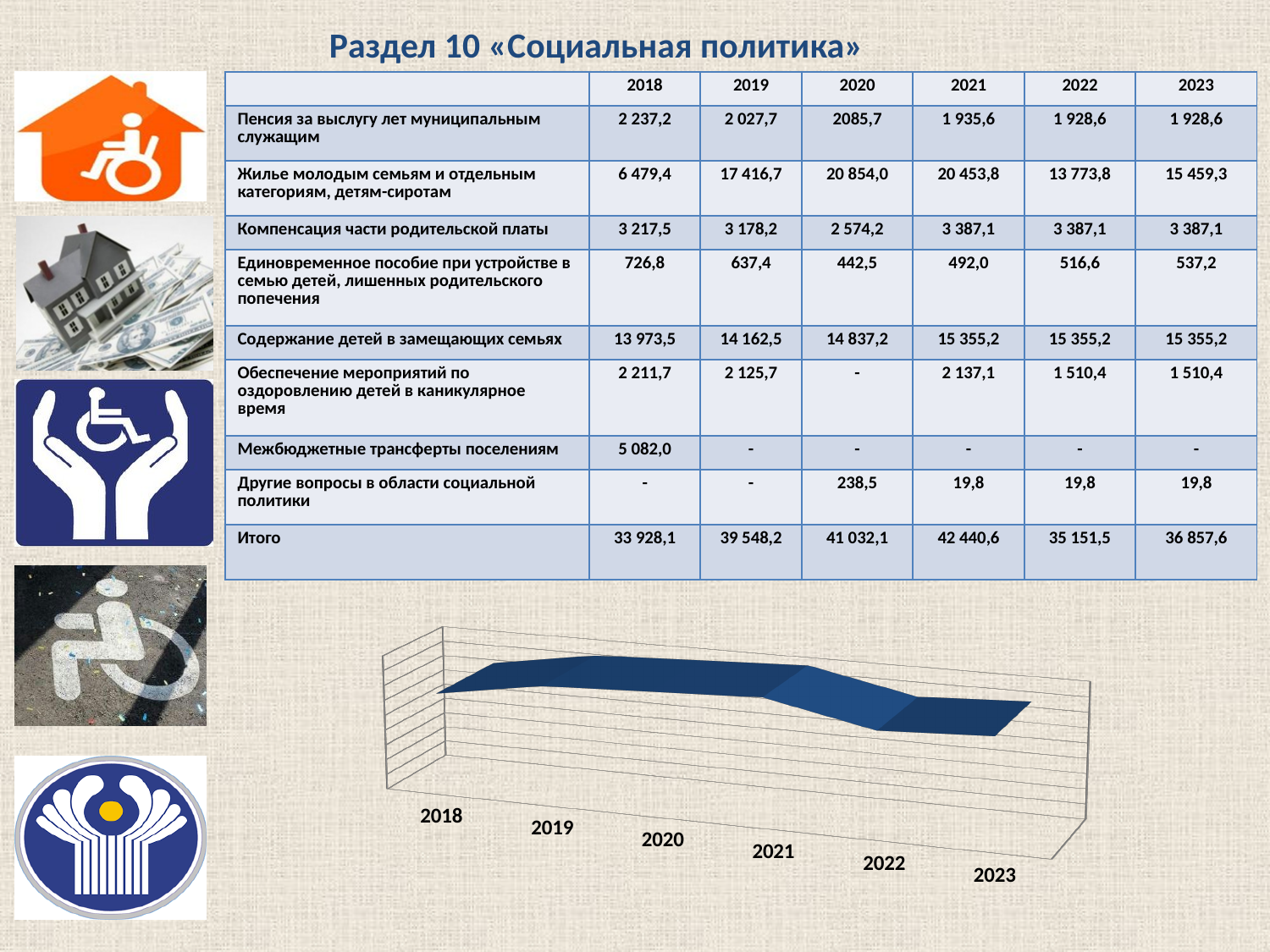
Which year is the first category on the chart's x axis? 2018 Does the plotted value rise or fall from 2021 to 2022 in the chart? fall How many years are shown along the x axis of the chart? 6 Does the plotted value rise or fall from 2018 to 2019 in the chart? rise Which year is the last category on the chart's x axis? 2023 What kind of chart is shown at the bottom of the slide? line chart Is the plotted value for 2019 larger or smaller than the value for 2018 in the chart? larger Is the plotted value for 2022 larger or smaller than the value for 2021 in the chart? smaller